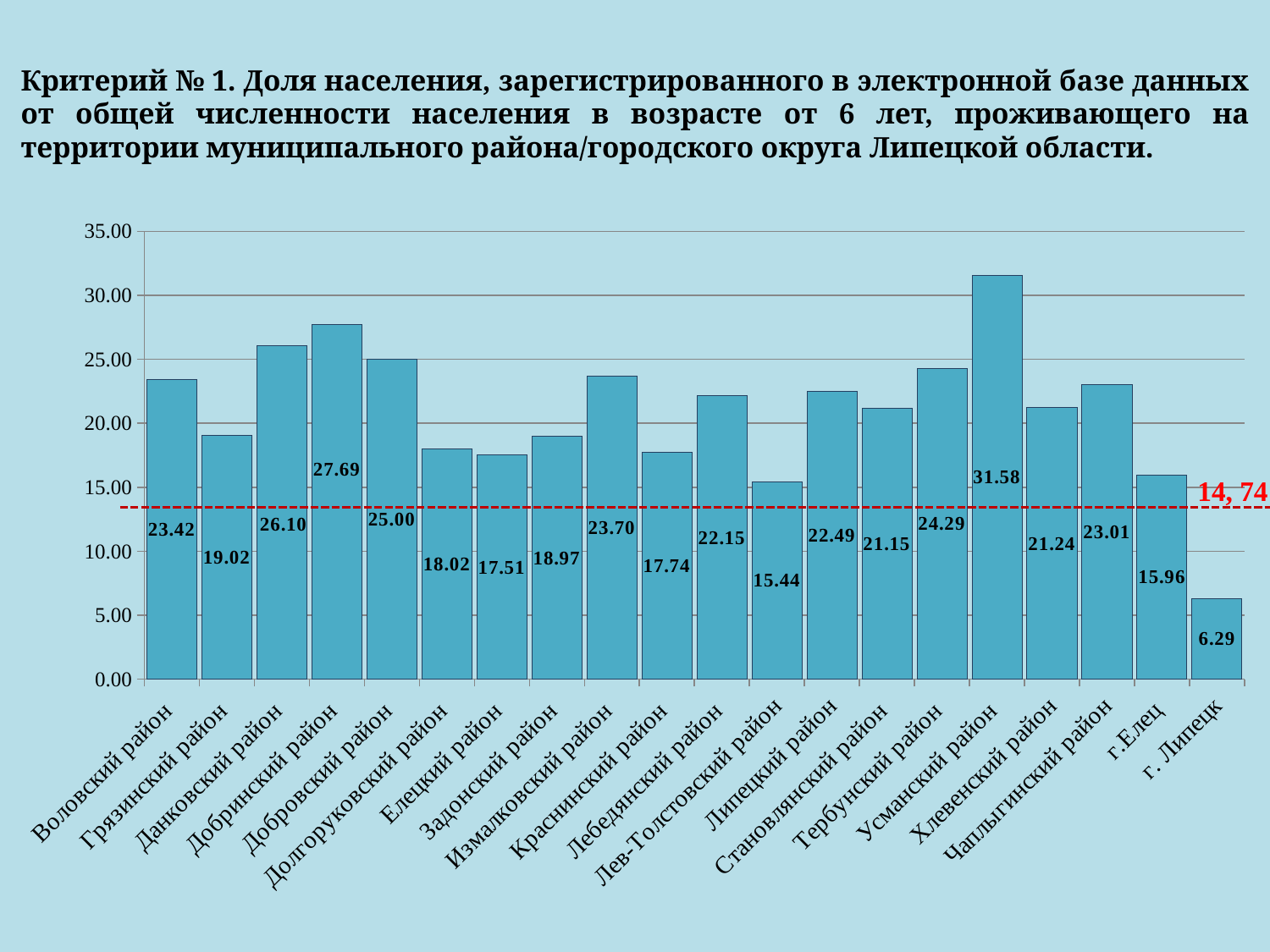
What is the value for Добринский район? 27.69 How many categories are shown on the x axis? 20 Is the value for Лев-Толстовский район greater or less than 20.00? less What is the difference between the values for Тербунский район and Становлянский район? 3.14 What is the value for Усманский район? 31.58 Which is larger, the value for Данковский район or the value for Добровский район? Данковский район What kind of chart is shown on the slide? bar chart What is the difference between the values for Усманский район and г. Липецк? 25.29 Which category has the lowest value? г. Липецк What value is marked by the red dashed horizontal line? 14,74 Which category has the highest value? Усманский район What is the value for г. Липецк? 6.29